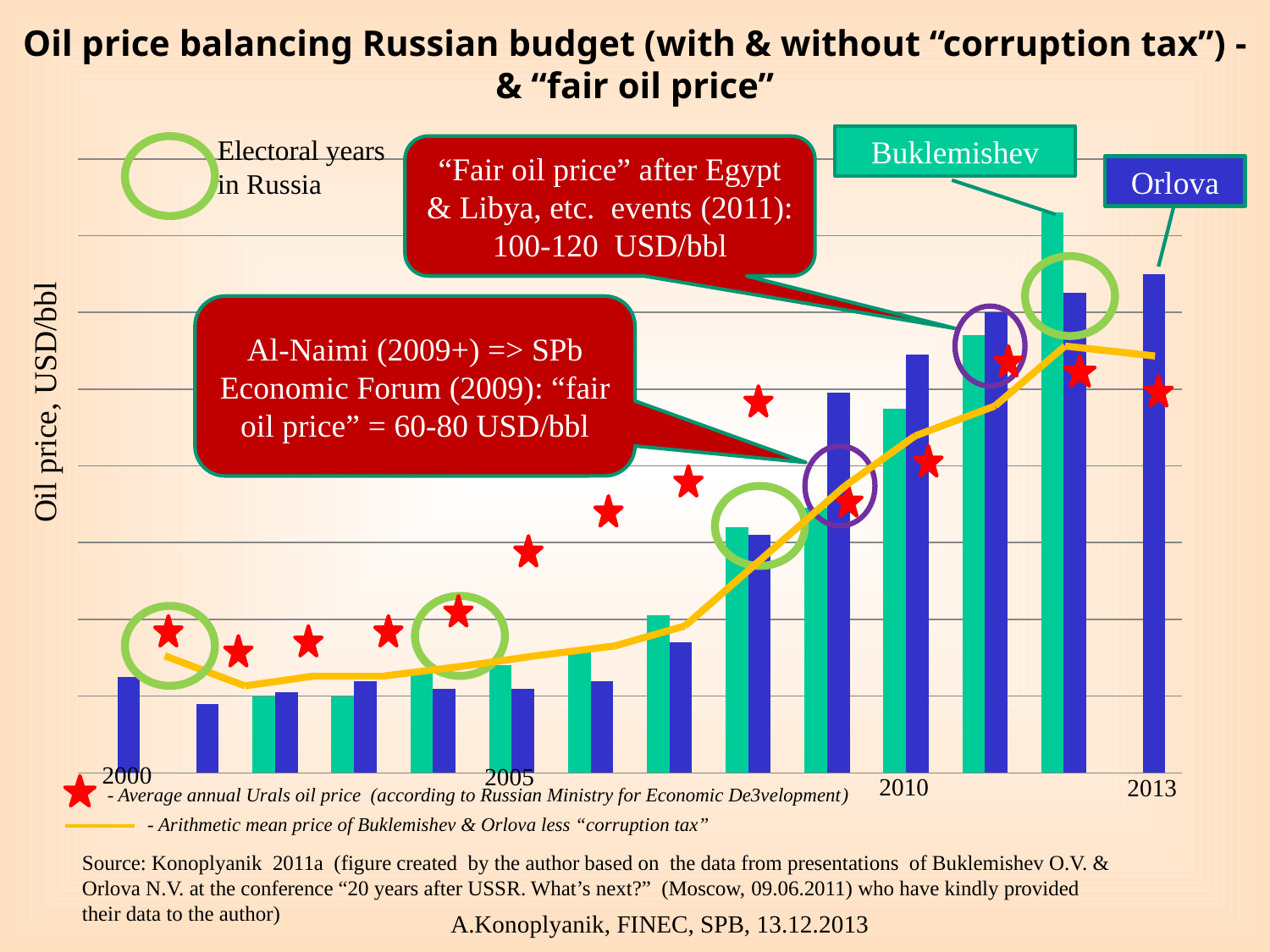
In 2010, which bar is taller: Buklemishev or Orlova? Orlova What is the last year shown on the x axis of the chart? 2013 Which two bar series are named in the legend boxes above the chart? Buklemishev and Orlova What is the label on the vertical axis of the chart? Oil price, USD/bbl What does the yellow line on the chart represent, according to the legend? Arithmetic mean price of Buklemishev & Orlova less "corruption tax" What kind of chart is shown on the slide? bar chart In 2012, which bar is taller: Buklemishev or Orlova? Buklemishev What is the first year shown on the x axis of the chart? 2000 In which year is the Buklemishev (green) bar the tallest? 2012 Do the Orlova bars generally rise or fall from 2005 to 2013? rise Which year has the lowest Orlova (blue) bar? 2001 In which year is the Orlova (blue) bar the tallest? 2013